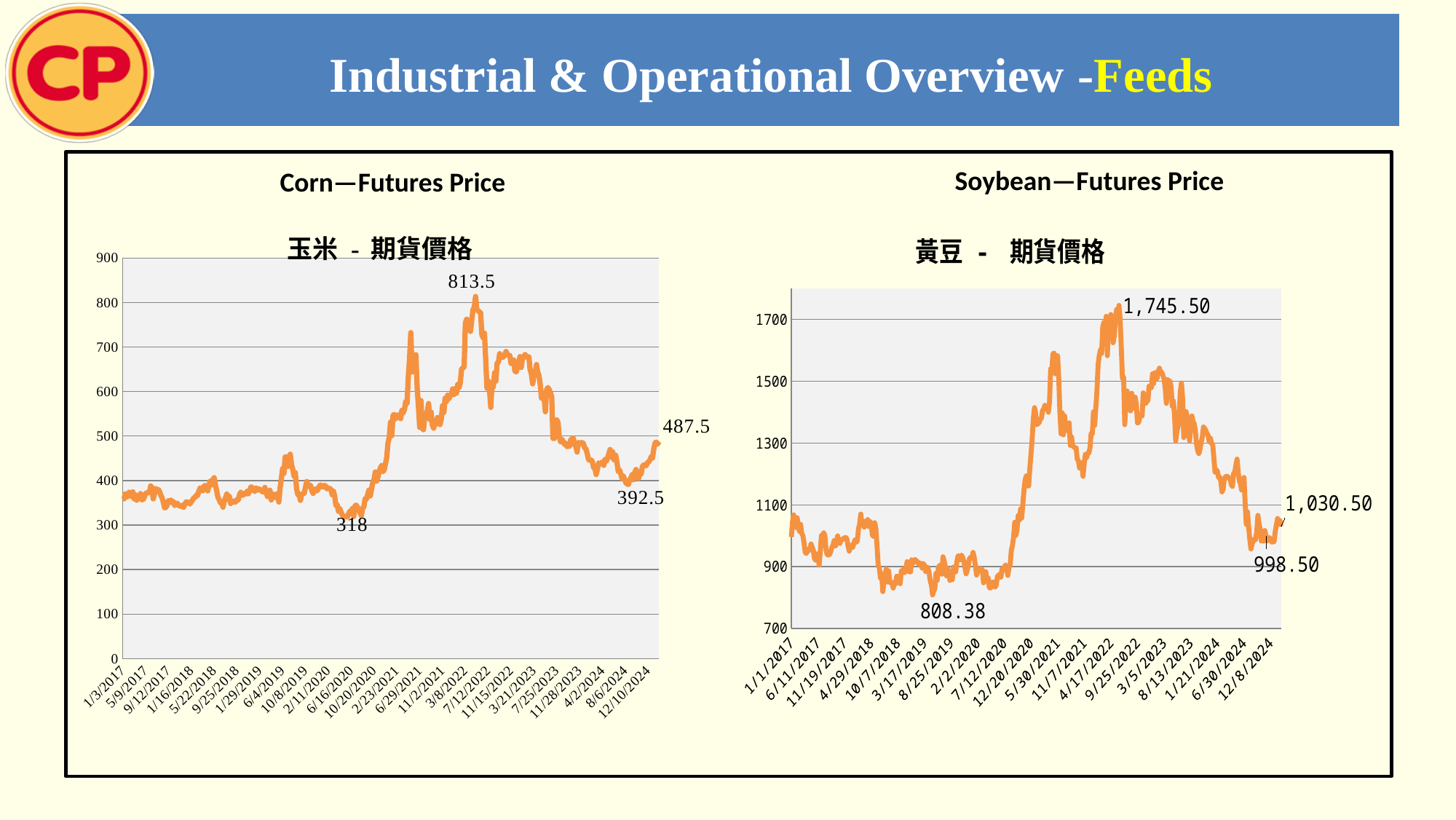
On the Corn—Futures Price chart, what is the difference between the labelled peak of 813.5 and the labelled low of 318? 495.5 On the Corn—Futures Price chart, what is the highest labelled value? 813.5 On the Corn—Futures Price chart, does the price rise or fall between 7/12/2022 and 8/6/2024? fall What kind of chart is the Corn—Futures Price chart? line chart On the Soybean—Futures Price chart, what is the last labelled value at the right end of the line? 1,030.50 On the Corn—Futures Price chart, what is the lowest labelled value? 318 On the Corn—Futures Price chart, how much higher is the final labelled value of 487.5 than the labelled value of 392.5? 95 On the Soybean—Futures Price chart, what is the lowest labelled value? 808.38 On the Soybean—Futures Price chart, what is the difference between the final labelled value of 1,030.50 and the labelled value of 998.50? 32.00 On the Corn—Futures Price chart, is the value at 1/3/2017 greater or less than 400? less On the Corn—Futures Price chart, what is the last labelled value at the right end of the line? 487.5 On the Soybean—Futures Price chart, what is the highest labelled value? 1,745.50